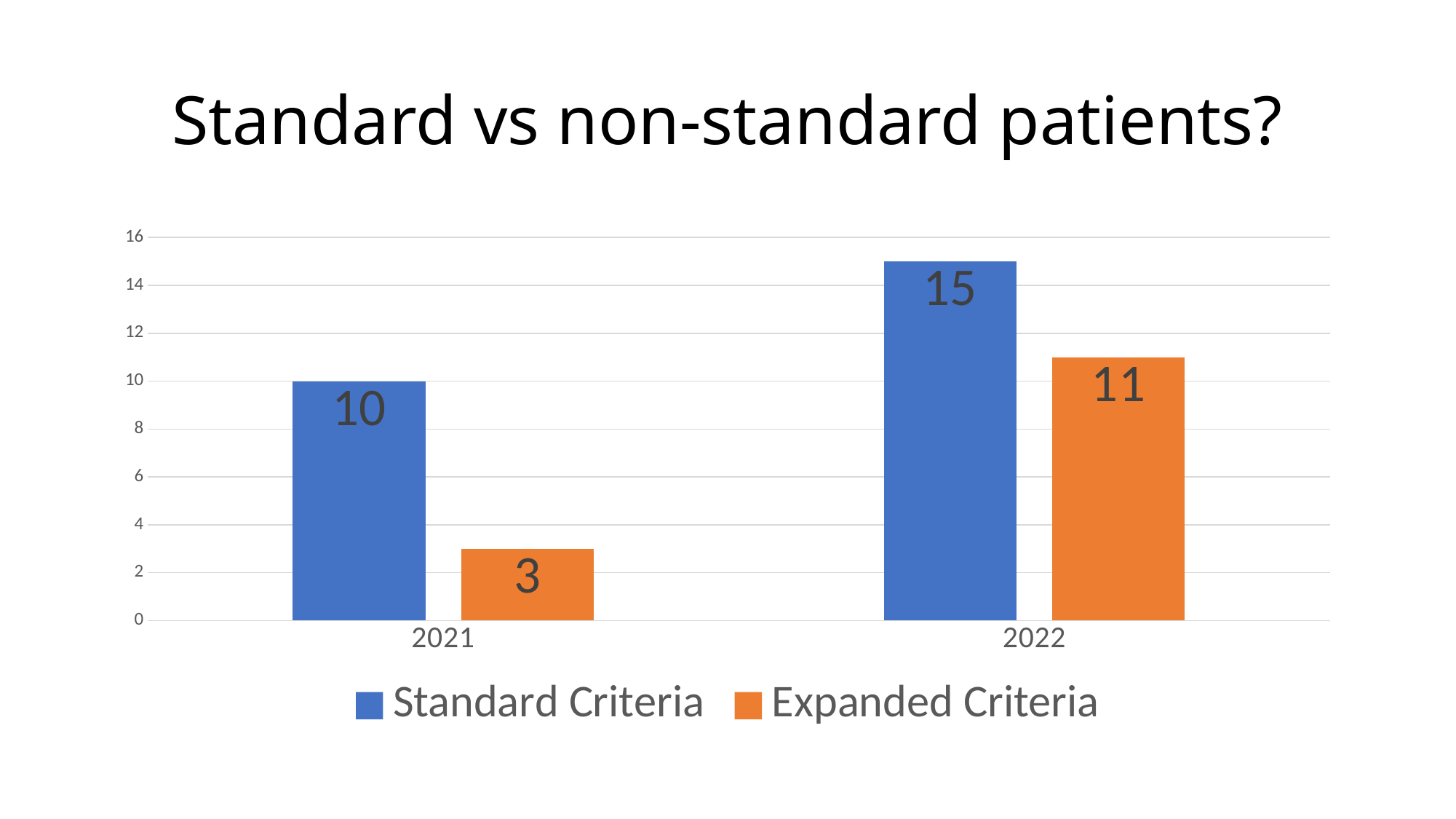
Which is larger in 2021, Standard Criteria or Expanded Criteria? Standard Criteria What is the value for Standard Criteria in 2021? 10 What is the value for Expanded Criteria in 2021? 3 What is the value for Expanded Criteria in 2022? 11 By how much did the Expanded Criteria value increase from 2021 to 2022? 8 How many years are shown on the x axis? 2 What kind of chart is shown on the slide? Bar chart How many series does the legend list? 2 Which year has the highest Standard Criteria value? 2022 Which year has the lowest Expanded Criteria value? 2021 What is the title of the slide? Standard vs non-standard patients? What is the difference between Standard Criteria and Expanded Criteria in 2022? 4